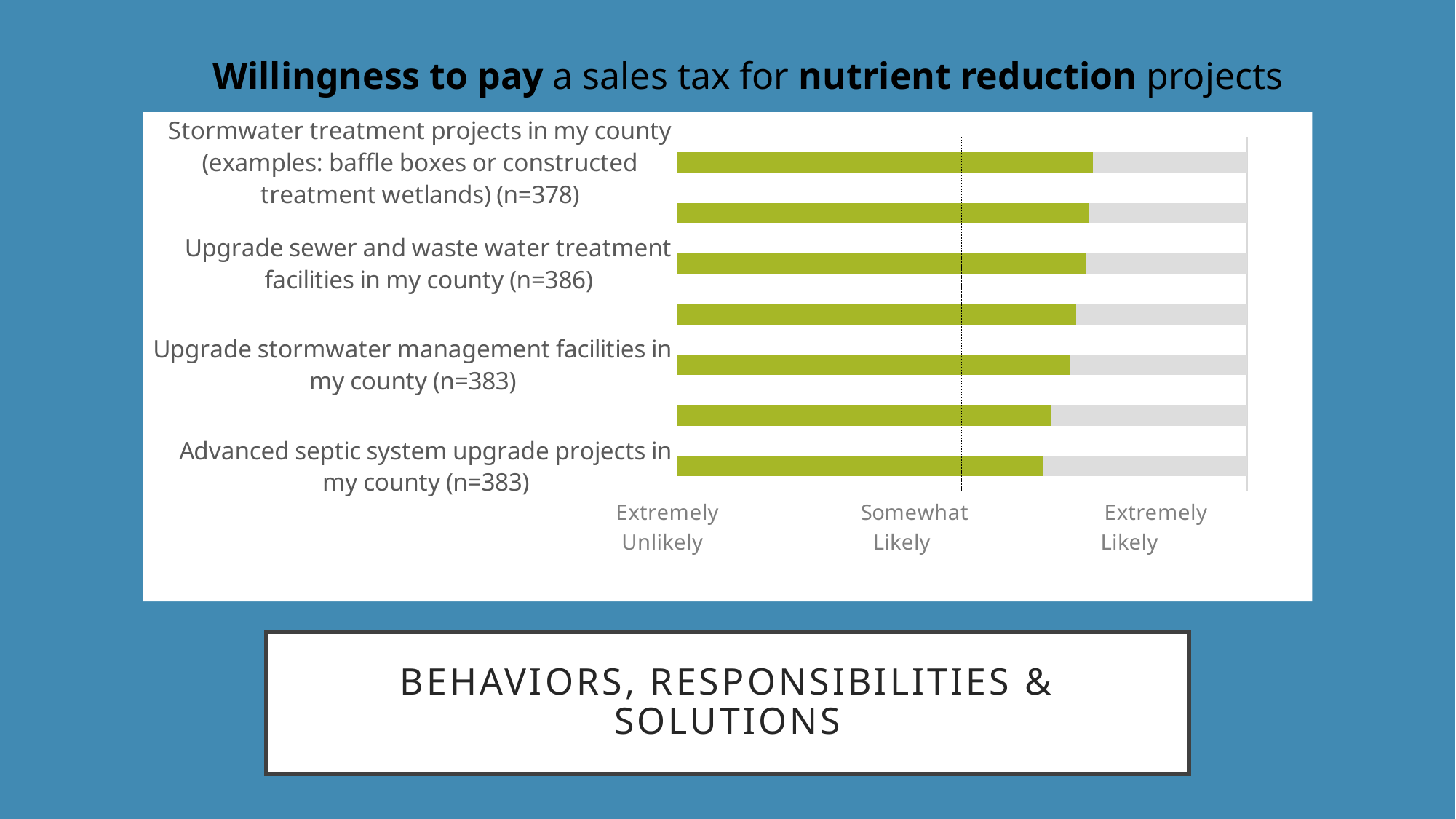
What kind of chart is shown on the slide? Bar chart Is the bottom bar's value greater or less than the 'Somewhat Likely' mark? Greater Do all of the bars extend past the 'Somewhat Likely' dotted line? Yes Do the bars get longer or shorter going from the top of the chart to the bottom? Shorter Does any bar reach the 'Extremely Likely' mark? No How many green bars are plotted in the chart? 7 What are the three labels shown along the horizontal axis? Extremely Unlikely, Somewhat Likely, Extremely Likely Which bar is the longest in the chart? The top bar Which bar is the shortest in the chart? The bottom bar What is the title of the chart? Willingness to pay a sales tax for nutrient reduction projects Which is longer, the top bar or the bottom bar? The top bar